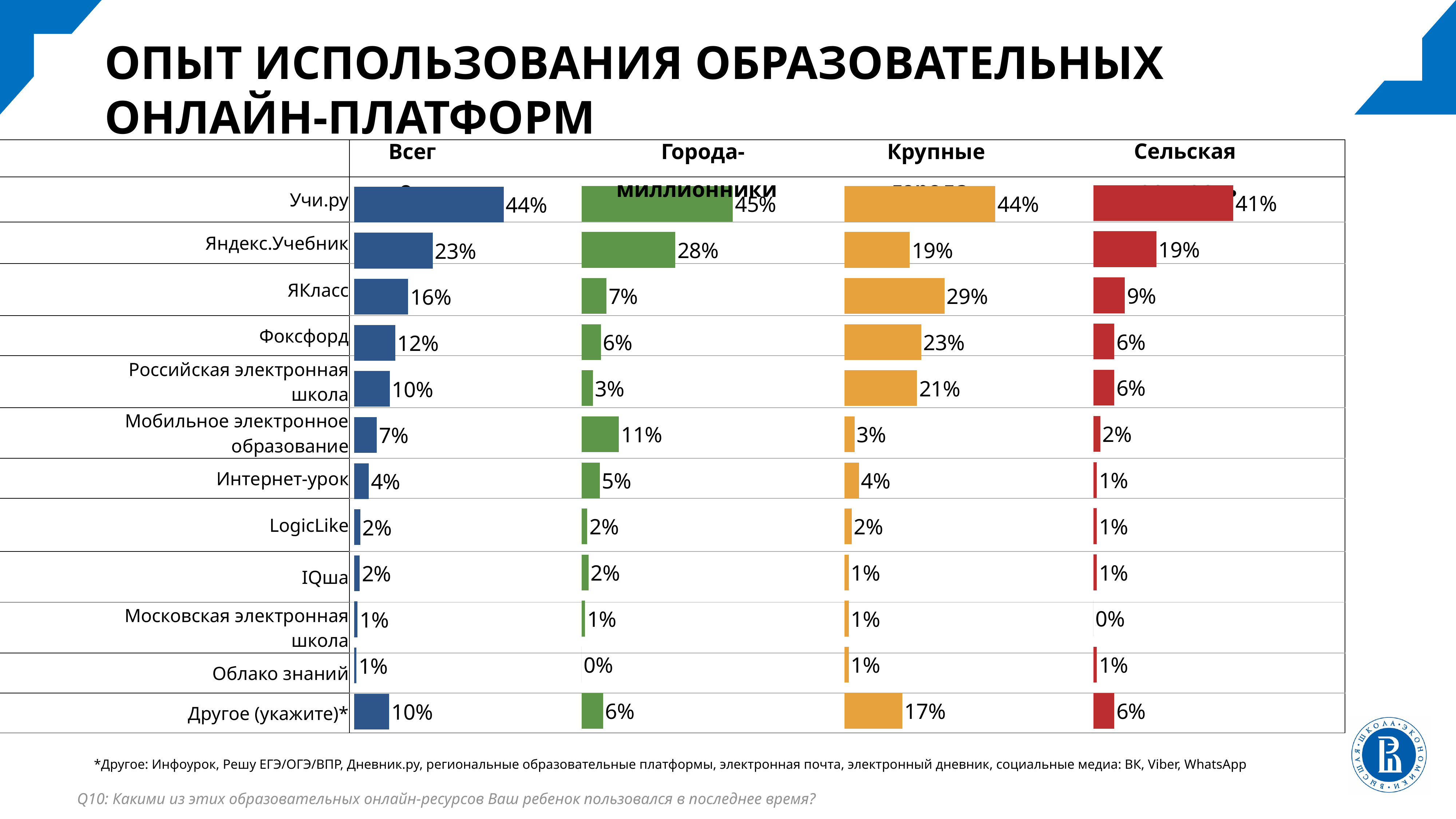
In the first (leftmost, blue) chart, what is the value for Учи.ру? 44% What colour are the bars in the third chart (Крупные города)? Orange What type of chart is used on this slide? Bar chart In the fourth (rightmost, red) chart, which platform has the lowest value? Московская электронная школа In the third (orange) chart, what is the value for ЯКласс? 29% How many platform categories are listed in the charts? 12 In the Города-миллионники (green) chart, what is the value for Яндекс.Учебник? 28% In the first (leftmost, blue) chart, which is larger: the value for Яндекс.Учебник or the value for ЯКласс? Яндекс.Учебник In the Города-миллионники (green) chart, which platform has the highest value? Учи.ру In the third (orange) chart, what is the difference between the values for ЯКласс and Фоксфорд? 6% In the Города-миллионники (green) chart, what is the value for Мобильное электронное образование? 11% In the fourth (rightmost, red) chart, what is the value for Фоксфорд? 6%